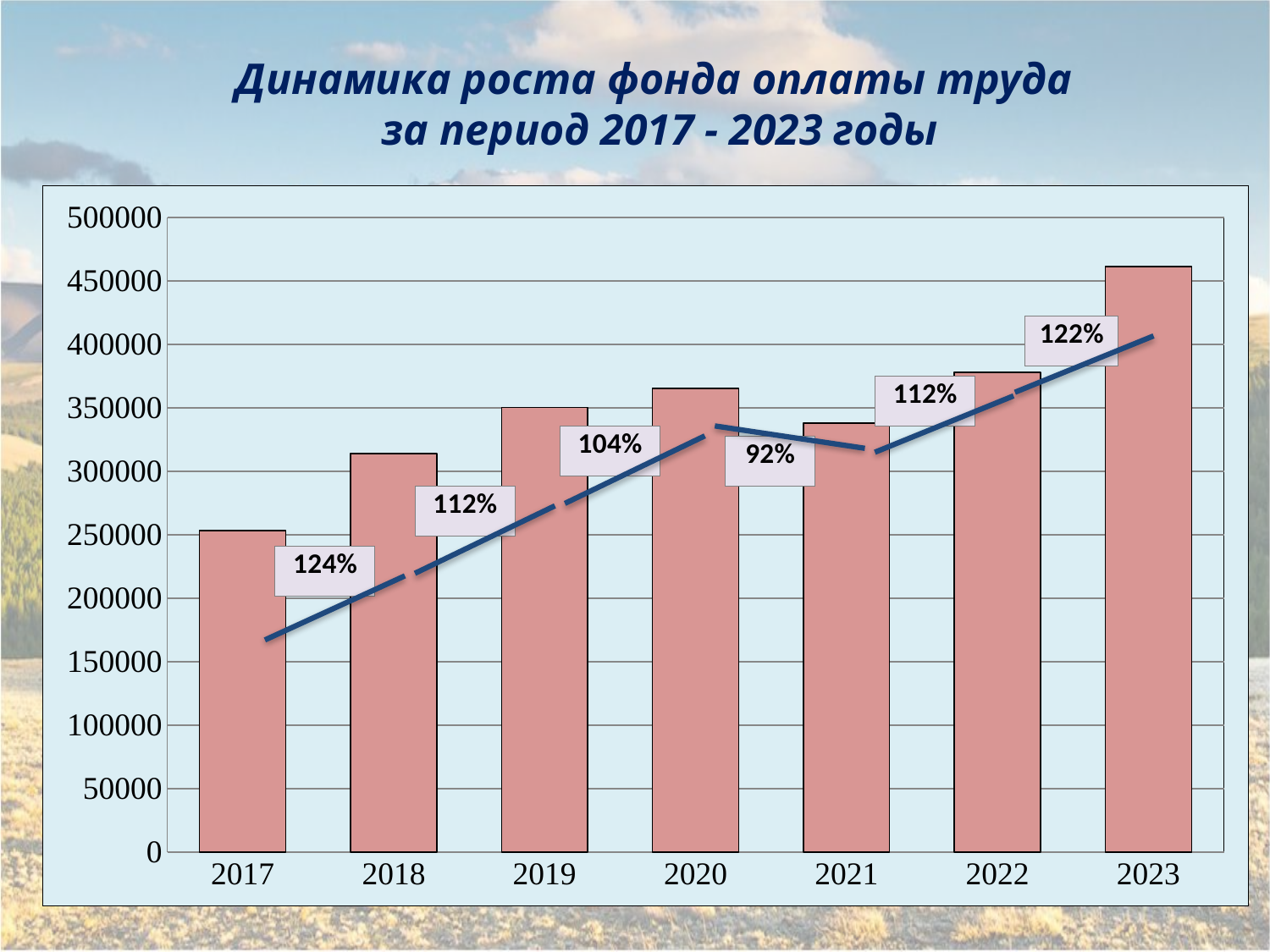
Which year has the lowest bar in the chart? 2017 What percentage label is shown on the line between 2017 and 2018? 124% Which year has the highest bar in the chart? 2023 What kind of chart is shown on the slide? bar chart Do the bar values rise or fall from 2017 to 2020? rise What percentage label is shown on the line between 2020 and 2021? 92% Is the value for 2023 greater or less than 450000? greater Is the value for 2019 greater or less than 300000? greater Which year has the taller bar, 2020 or 2021? 2020 What percentage label is shown on the line between 2022 and 2023? 122% Is the value for 2017 greater or less than 300000? less How many years are shown on the x axis of the chart? 7